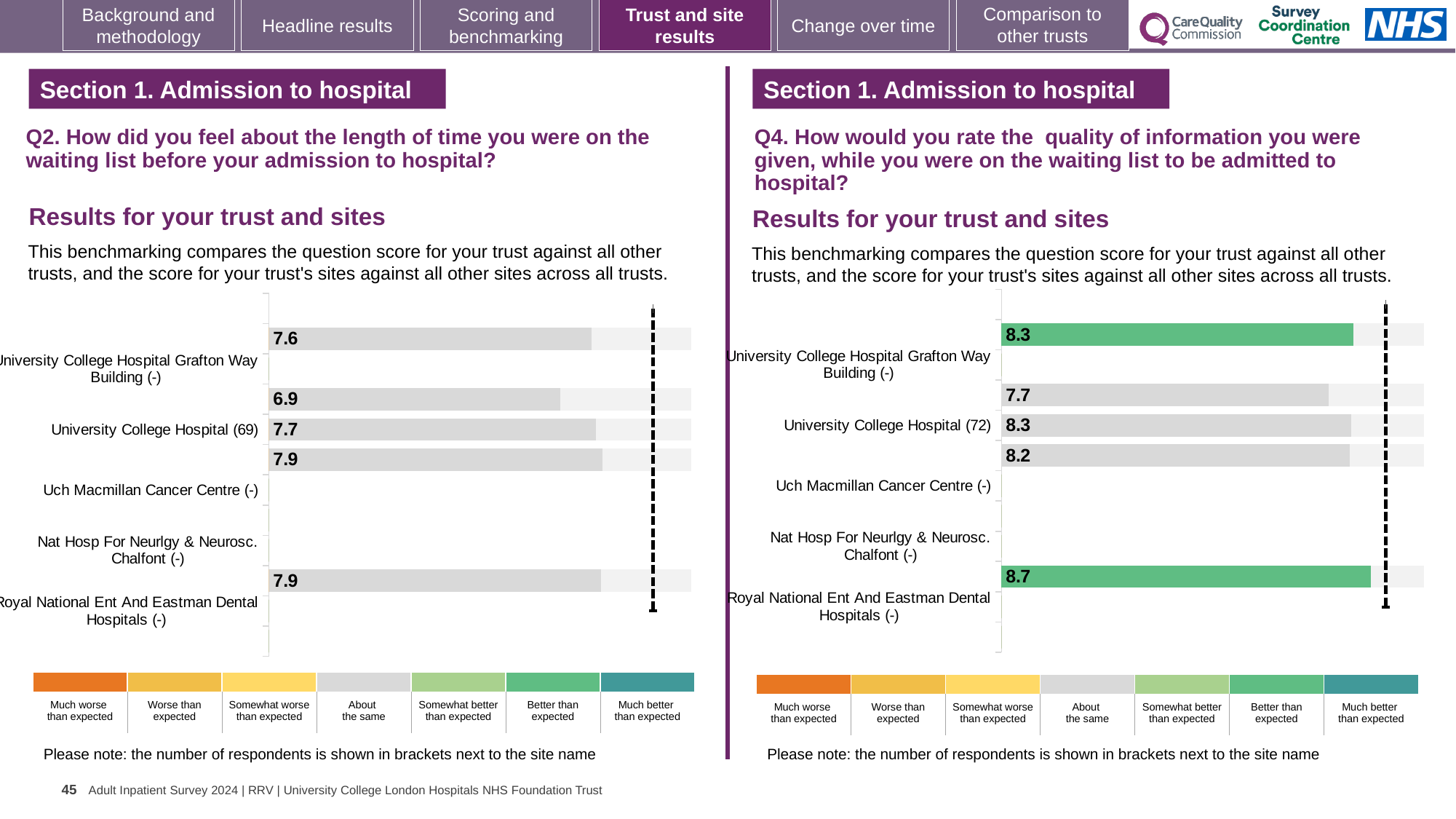
How many categories does the colour key below each chart list, from 'Much worse than expected' to 'Much better than expected'? 7 On the Q4 chart (right), what is the difference between the highest bar score (8.7) and the lowest bar score (7.7)? 1.0 On the Q4 chart (right), what is the lowest score shown on any bar? 7.7 On the Q2 chart (left), what is the lowest score shown on any bar? 6.9 What kind of chart is used on the left-hand (Q2) side of the slide? Bar chart On the Q2 chart (left), what is the highest score shown on any bar? 7.9 On the Q4 chart (right), what is the highest score shown on any bar? 8.7 On the Q2 chart (left), what is the difference between the highest bar score (7.9) and the lowest bar score (6.9)? 1.0 On the Q4 chart (right), how many bars have a data label? 5 On the Q4 chart (right), what colour is the bar labelled 8.7? Green On the Q4 chart (right), which is larger: the bar labelled 8.2 or the bar labelled 7.7? 8.2 On the Q2 chart (left), how many bars have a data label? 5